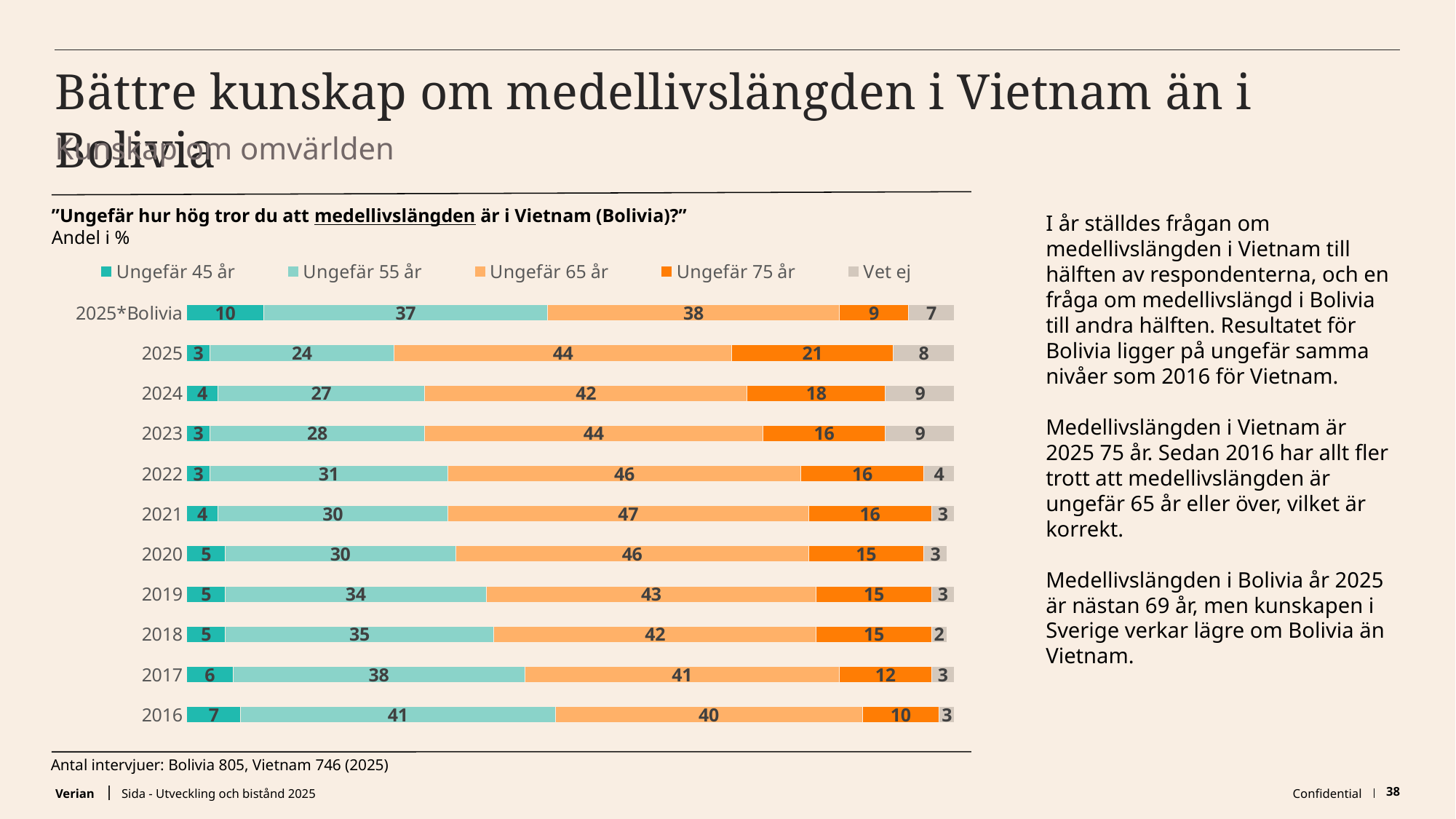
What kind of chart is shown on the slide? Stacked bar chart Which is larger: the 'Ungefär 55 år' value in 2016 or in 2025? 2016 How many series does the legend list? 5 What is the difference between the 'Ungefär 75 år' values for 2025 and 2016? 11 How many categories (rows) are plotted in the chart? 11 Does the 'Ungefär 45 år' value rise or fall from 2016 to 2025? Fall What is the total of the stacked bar for 2024? 100 What is the value for 'Ungefär 55 år' for 2025*Bolivia? 37 Which category has the highest value for 'Ungefär 45 år'? 2025*Bolivia What is the value for 'Ungefär 75 år' in 2025? 21 What is the value for 'Vet ej' in 2018? 2 Which year has the highest value for 'Ungefär 65 år'? 2021